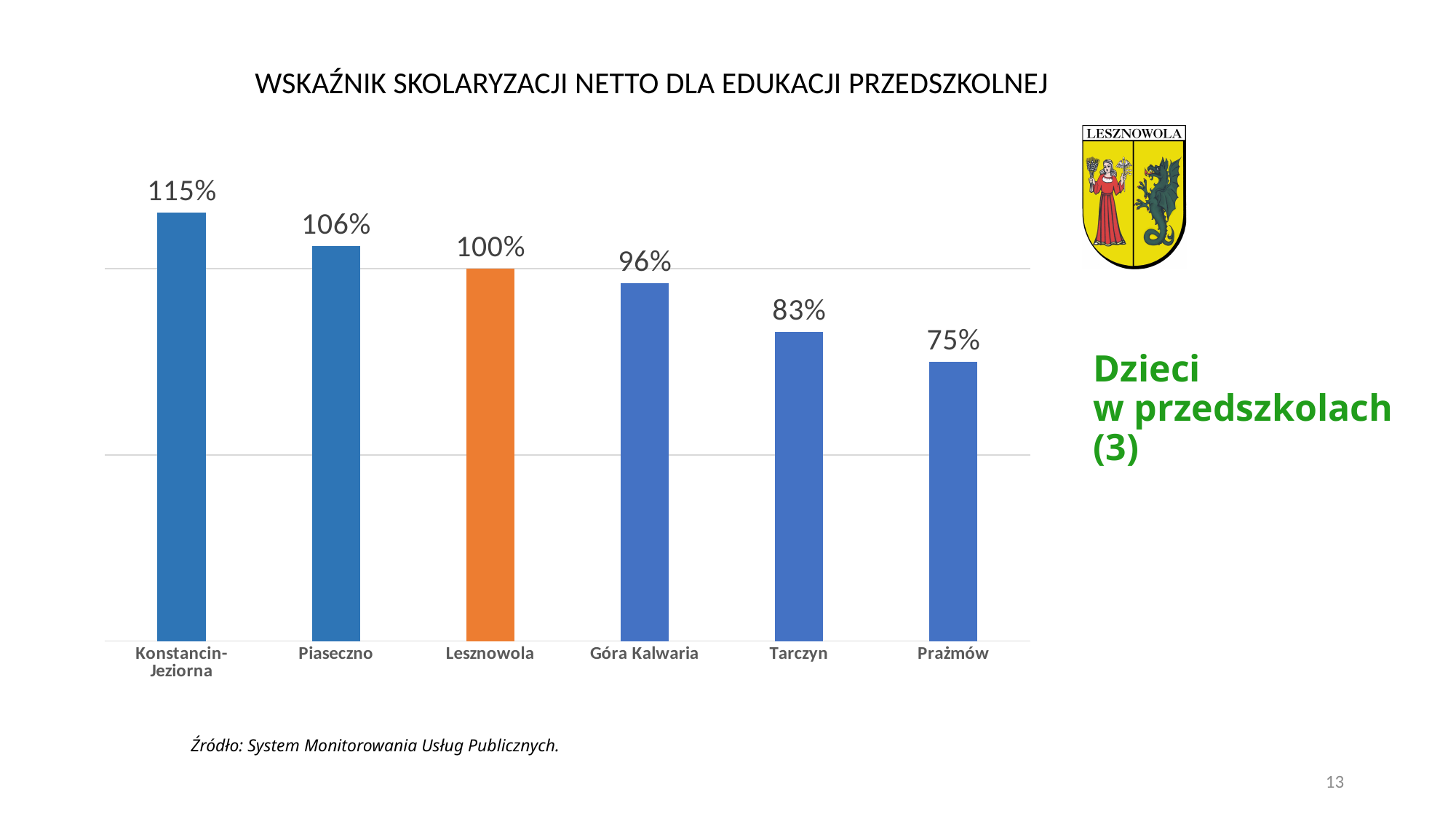
What is the difference between the values for Lesznowola and Prażmów? 25% What is the value for Góra Kalwaria? 96% What kind of chart is shown on the slide? Bar chart Which category's bar is coloured orange? Lesznowola Which category has the highest value? Konstancin-Jeziorna What is the difference between the values for Konstancin-Jeziorna and Piaseczno? 9% Do the values rise or fall from left to right along the x axis? Fall What is the value for Lesznowola? 100% Which category has the lowest value? Prażmów What is the value for Tarczyn? 83% How many categories are shown on the chart? 6 Which is larger, the value for Piaseczno or the value for Góra Kalwaria? Piaseczno